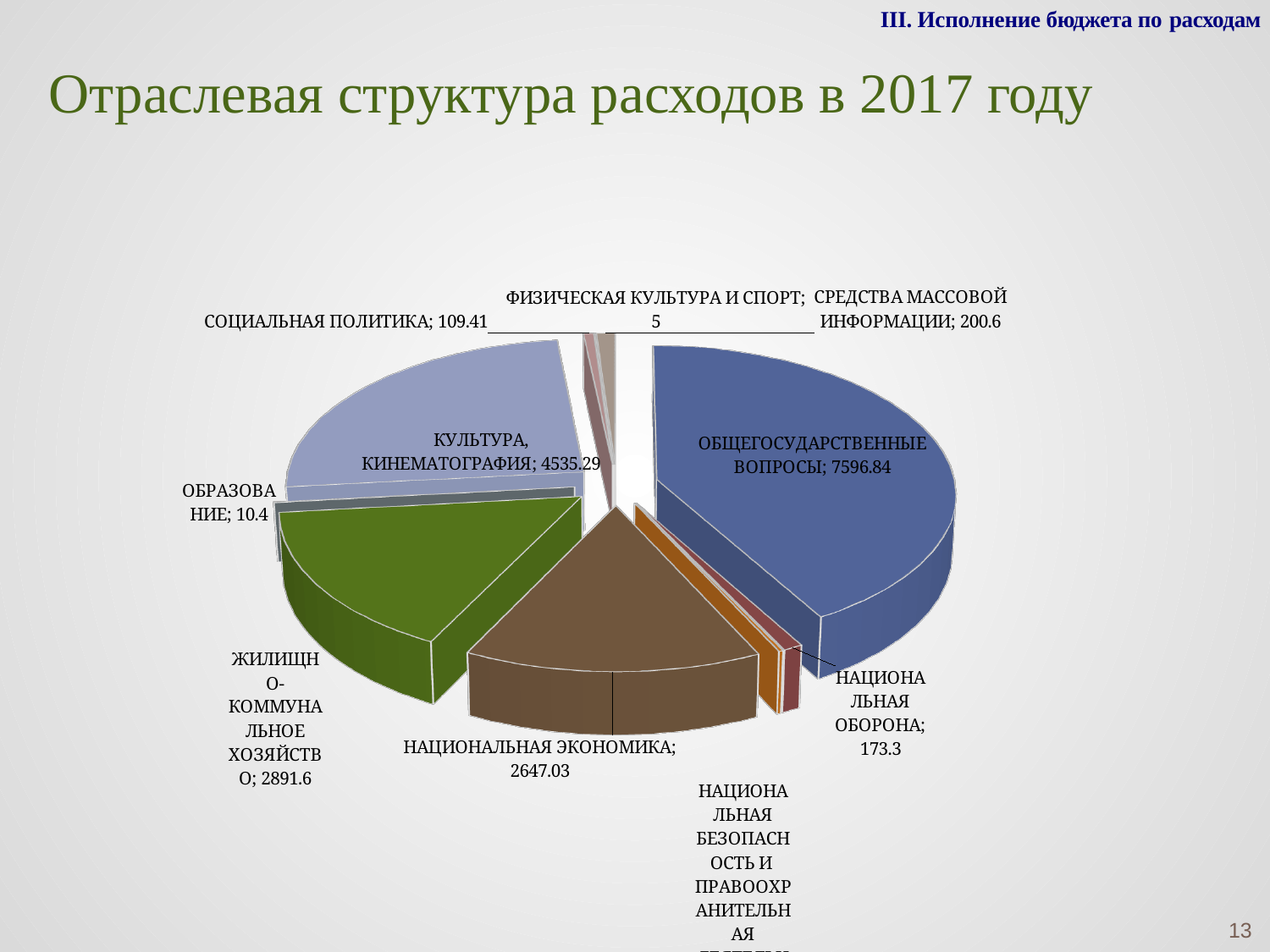
Which category has the largest value in the pie chart? ОБЩЕГОСУДАРСТВЕННЫЕ ВОПРОСЫ What is the value for НАЦИОНАЛЬНАЯ ЭКОНОМИКА? 2647.03 What is the value for ОБЩЕГОСУДАРСТВЕННЫЕ ВОПРОСЫ? 7596.84 What kind of chart is shown on the slide? Pie chart What is the difference between ОБЩЕГОСУДАРСТВЕННЫЕ ВОПРОСЫ and КУЛЬТУРА, КИНЕМАТОГРАФИЯ? 3061.55 Which is larger: СРЕДСТВА МАССОВОЙ ИНФОРМАЦИИ or НАЦИОНАЛЬНАЯ ОБОРОНА? СРЕДСТВА МАССОВОЙ ИНФОРМАЦИИ What is the value for СРЕДСТВА МАССОВОЙ ИНФОРМАЦИИ? 200.6 What is the difference between ЖИЛИЩНО-КОММУНАЛЬНОЕ ХОЗЯЙСТВО and НАЦИОНАЛЬНАЯ ЭКОНОМИКА? 244.57 How many categories (slices) are shown in the pie chart? 10 What is the value for КУЛЬТУРА, КИНЕМАТОГРАФИЯ? 4535.29 What is the value for ЖИЛИЩНО-КОММУНАЛЬНОЕ ХОЗЯЙСТВО? 2891.6 What is the title of the chart on the slide? Отраслевая структура расходов в 2017 году